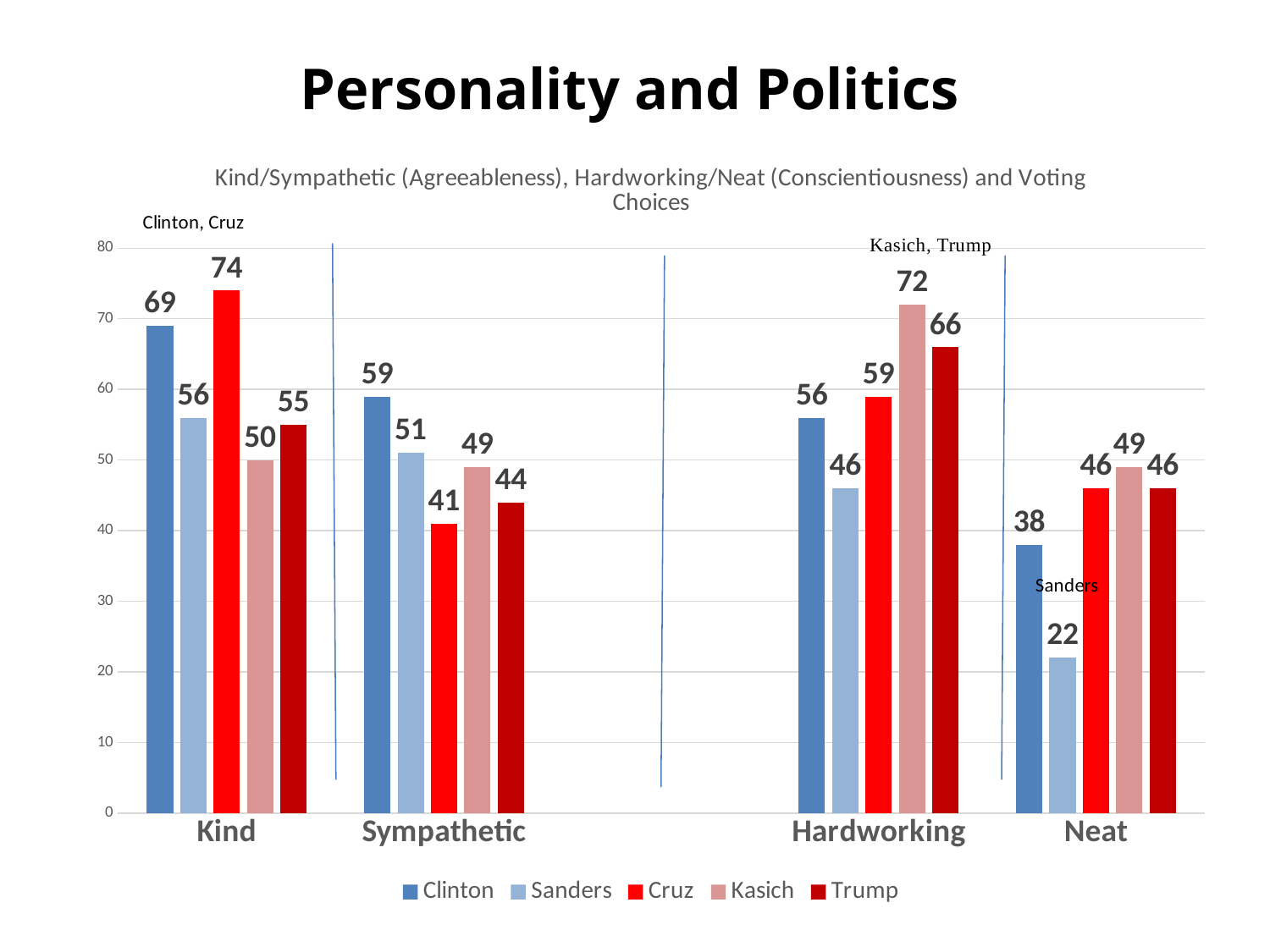
What is the value for Cruz in the Kind category? 74 Which candidate has the lowest value in the Hardworking category? Sanders What is the value for Kasich in the Hardworking category? 72 Which candidate has the highest value in the Sympathetic category? Clinton What is the difference between Clinton's and Sanders' values in the Neat category? 16 How many categories are shown on the x axis? 4 Which candidate is represented by the bright red bars in the legend? Cruz Which is larger in the Kind category: Trump's value or Kasich's value? Trump's value How many series does the legend list? 5 What kind of chart is shown on the slide? Bar chart What is the value for Sanders in the Neat category? 22 What is the difference between Cruz's values in the Kind and Sympathetic categories? 33